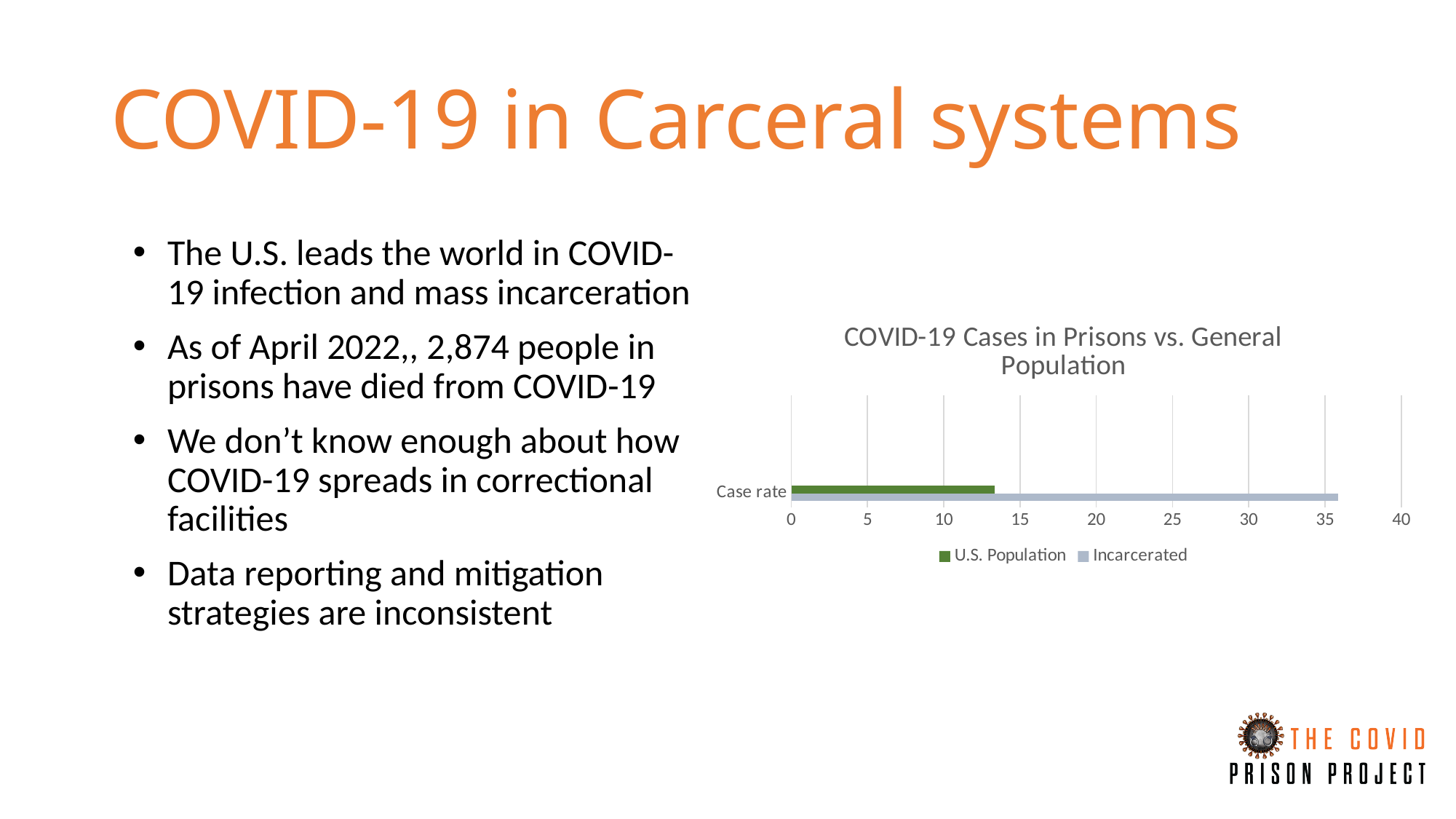
What is the name of the single category shown on the chart? Case rate Is the case rate for U.S. Population greater or less than 10? greater How many series does the chart's legend list? 2 Which series has the higher case rate, U.S. Population or Incarcerated? Incarcerated What kind of chart is shown on the slide? bar chart Which series has the lowest case rate on the chart? U.S. Population Is the case rate for Incarcerated greater or less than 40? less Which series has the highest case rate on the chart? Incarcerated Is the case rate for Incarcerated greater or less than 30? greater How many categories are plotted on the chart's vertical axis? 1 What is the title of the chart? COVID-19 Cases in Prisons vs. General Population